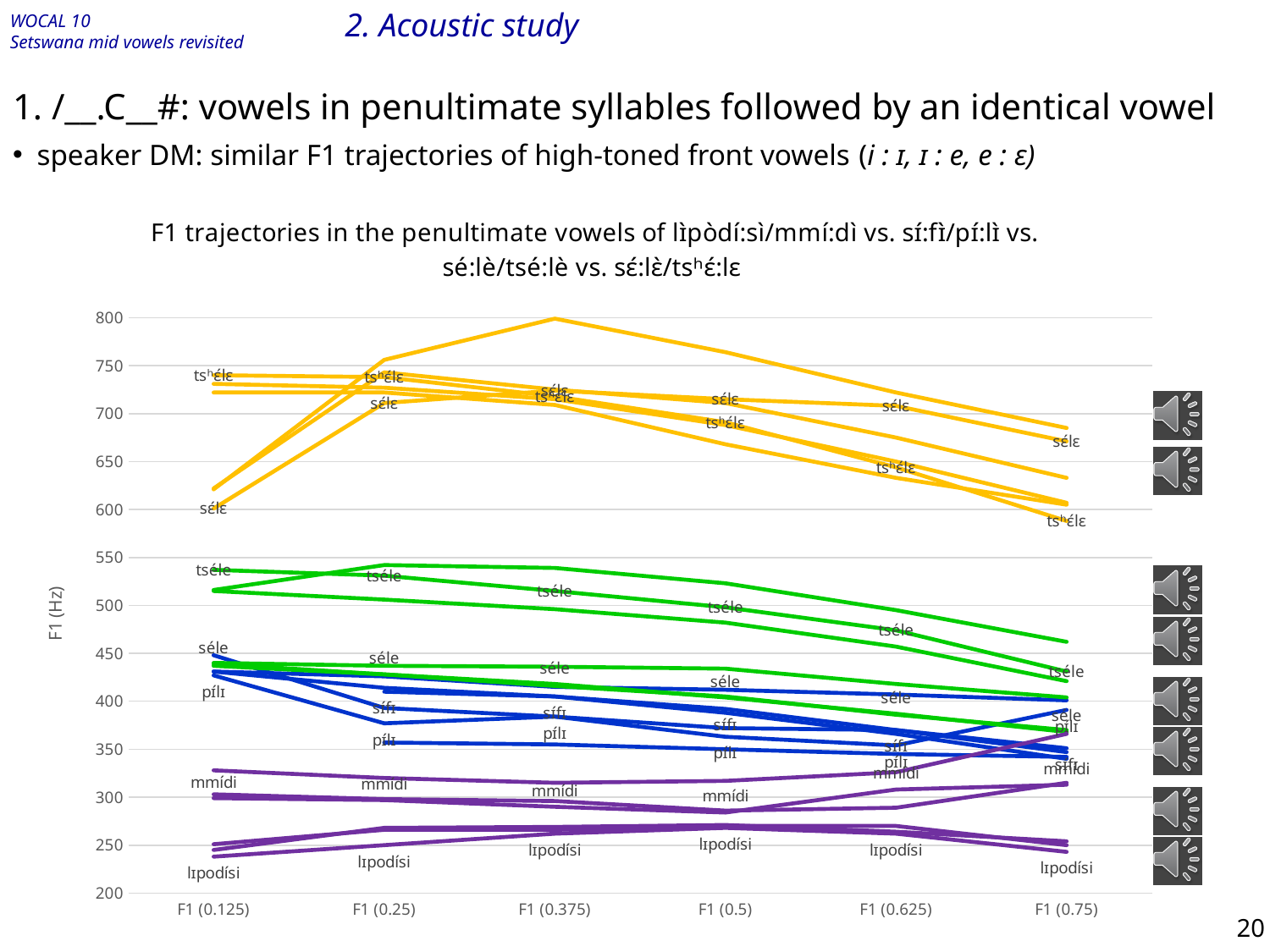
Are the tsʰɛ́lɛ values at F1 (0.25) greater or less than 650? greater Which word's trajectories reach the lowest F1 values in the chart? lɪpodísi How many time points are shown along the x axis of the chart? 6 At F1 (0.5), which is higher: the sɛ́lɛ trajectories or the séle trajectories? sɛ́lɛ Are the mmídi values at F1 (0.375) greater or less than 350? less What kind of chart is shown on the slide? line chart What is the label of the y axis of the chart? F1 (Hz) Are the lɪpodísi values at F1 (0.5) greater or less than 300? less What is the highest value shown on the y axis of the chart? 800